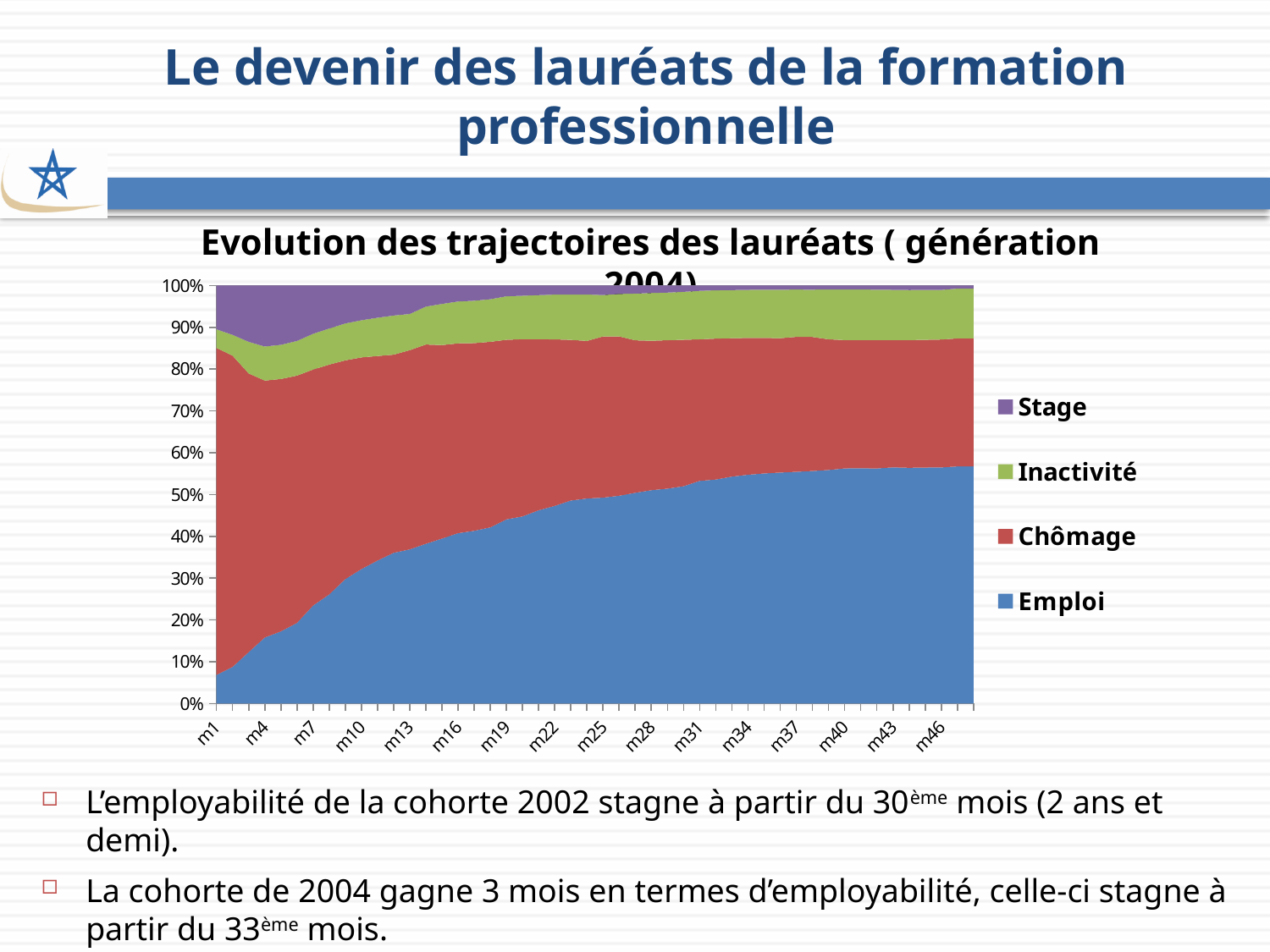
Is the share of Emploi at m46 greater or less than 50%? greater Is the share of Emploi at m1 greater or less than 10%? less Which series has the largest share at m1? Chômage What are the series listed in the legend? Stage, Inactivité, Chômage, Emploi Is the share of Chômage at m4 greater or less than 50%? greater How many series does the legend list? 4 Does the share of Emploi rise or fall from m1 to m46? rise At m46, which is larger: the share of Emploi or the share of Chômage? Emploi Which series has the largest share at m46? Emploi Does the share of Chômage rise or fall from m4 to m46? fall What is the title of the chart? Evolution des trajectoires des lauréats ( génération 2004) What kind of chart is shown on the slide? stacked area chart